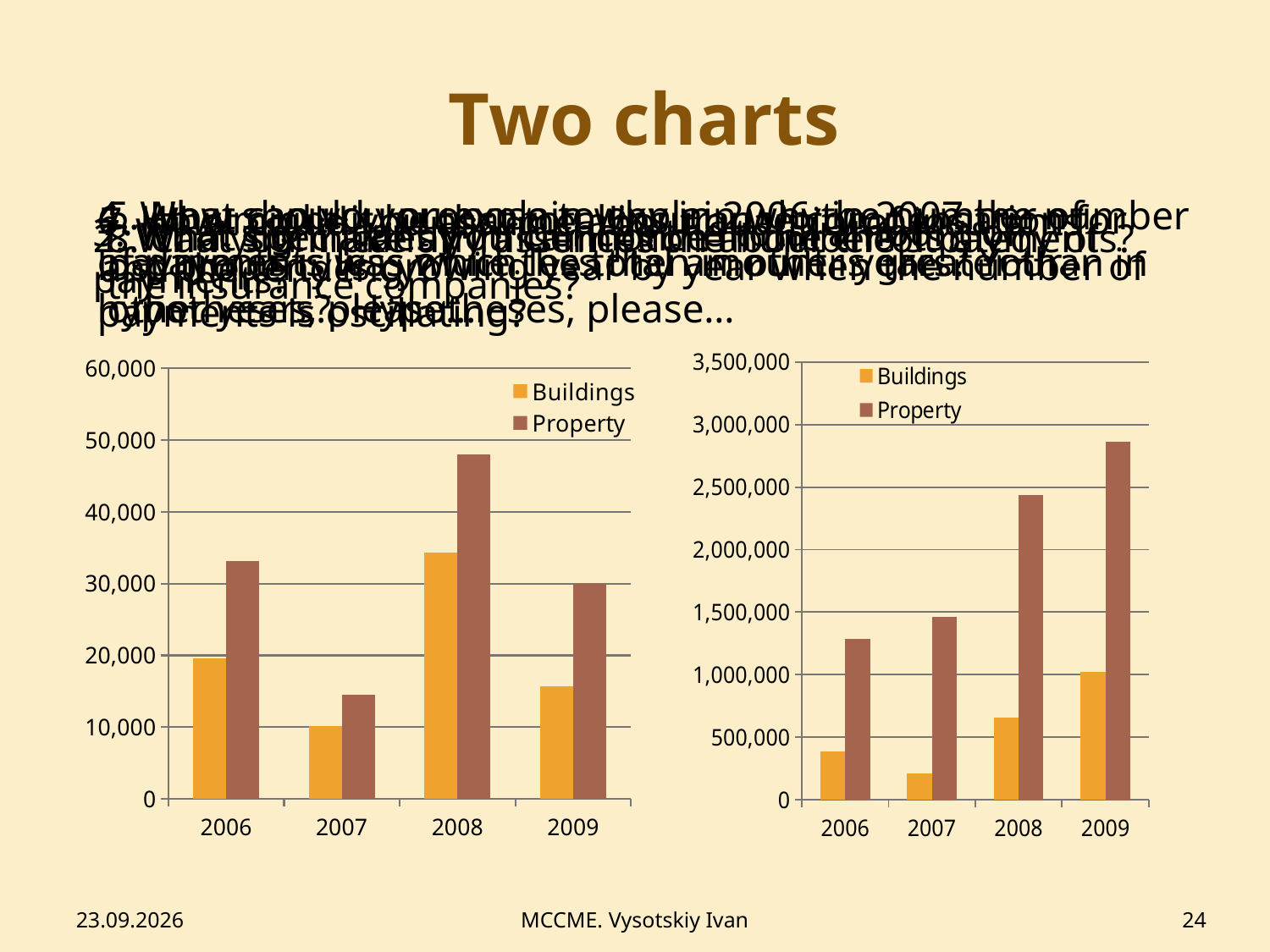
In the left chart, which is larger for 2006: Buildings or Property? Property In the left chart, is the Buildings value for 2007 greater or less than 20,000? less What kind of chart is the left chart on the slide? bar chart In the right chart, do the Property values rise or fall from 2006 to 2009? rise How many series does the legend of the right chart list? 2 In the left chart, which year has the highest Property value? 2008 In the left chart, is the Property value for 2008 greater or less than 40,000? greater In the right chart, is the Property value for 2009 greater or less than 2,500,000? greater In the left chart, which year has the lowest Buildings value? 2007 How many years are shown on the x axis of the left chart? 4 In the right chart, which year has the lowest Buildings value? 2007 In the right chart, which year has the highest Property value? 2009